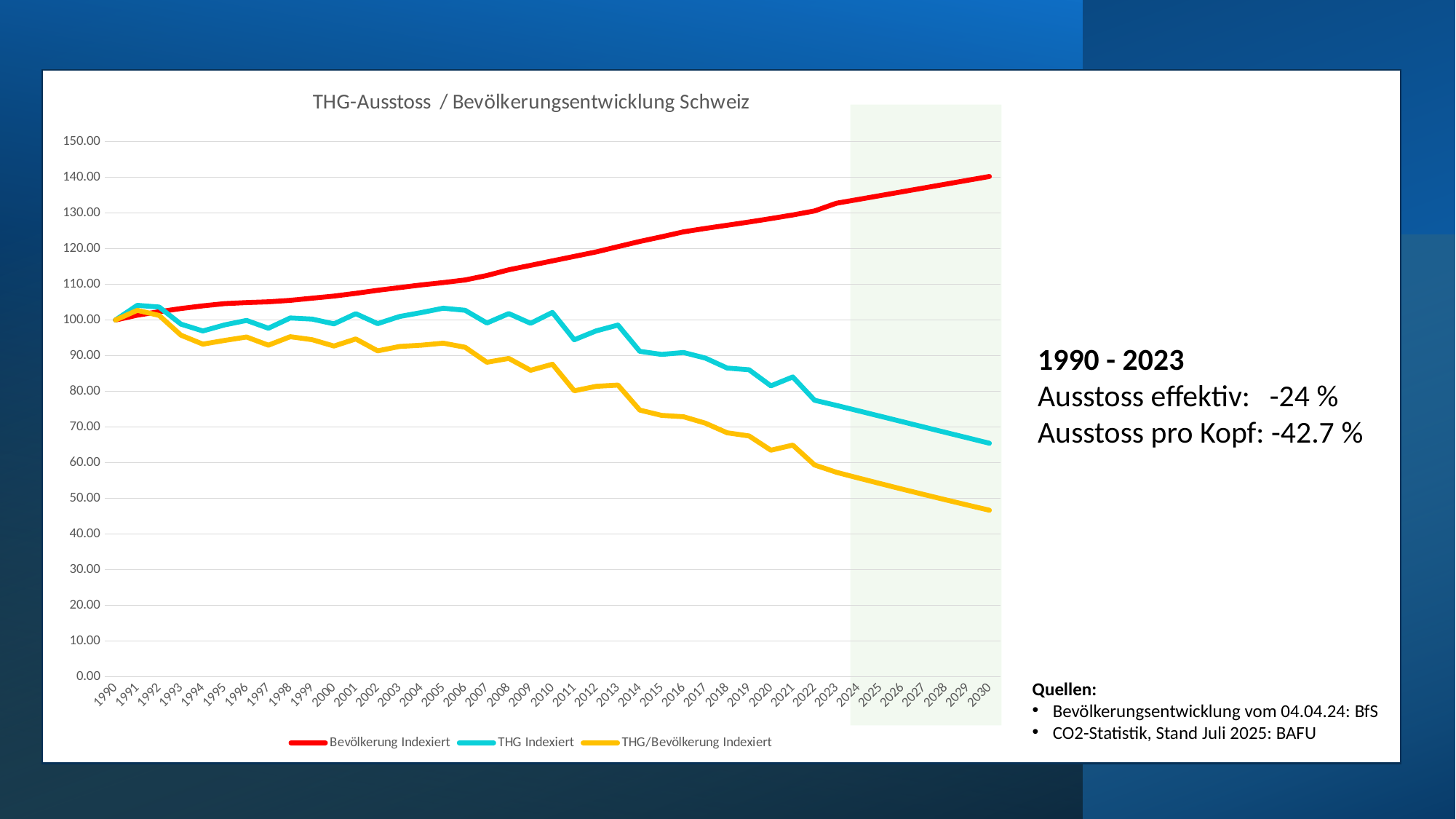
Is the value for 'THG Indexiert' in 2030 greater or less than 70.00? less What is the value of 'Bevölkerung Indexiert' in 1990? 100.00 How many series does the legend list? 3 Is the value for 'THG/Bevölkerung Indexiert' in 2030 greater or less than 50.00? less Does the 'Bevölkerung Indexiert' series rise or fall from 1990 to 2030? rise Which colour is used for the 'Bevölkerung Indexiert' series? red Is the value for 'Bevölkerung Indexiert' in 2030 greater or less than 130.00? greater In 2030, which is larger: 'Bevölkerung Indexiert' or 'THG Indexiert'? Bevölkerung Indexiert How many years are shown on the x axis? 41 Which series has the lowest value in 2030? THG/Bevölkerung Indexiert What is the title of the chart? THG-Ausstoss / Bevölkerungsentwicklung Schweiz What kind of chart is shown on the slide? line chart